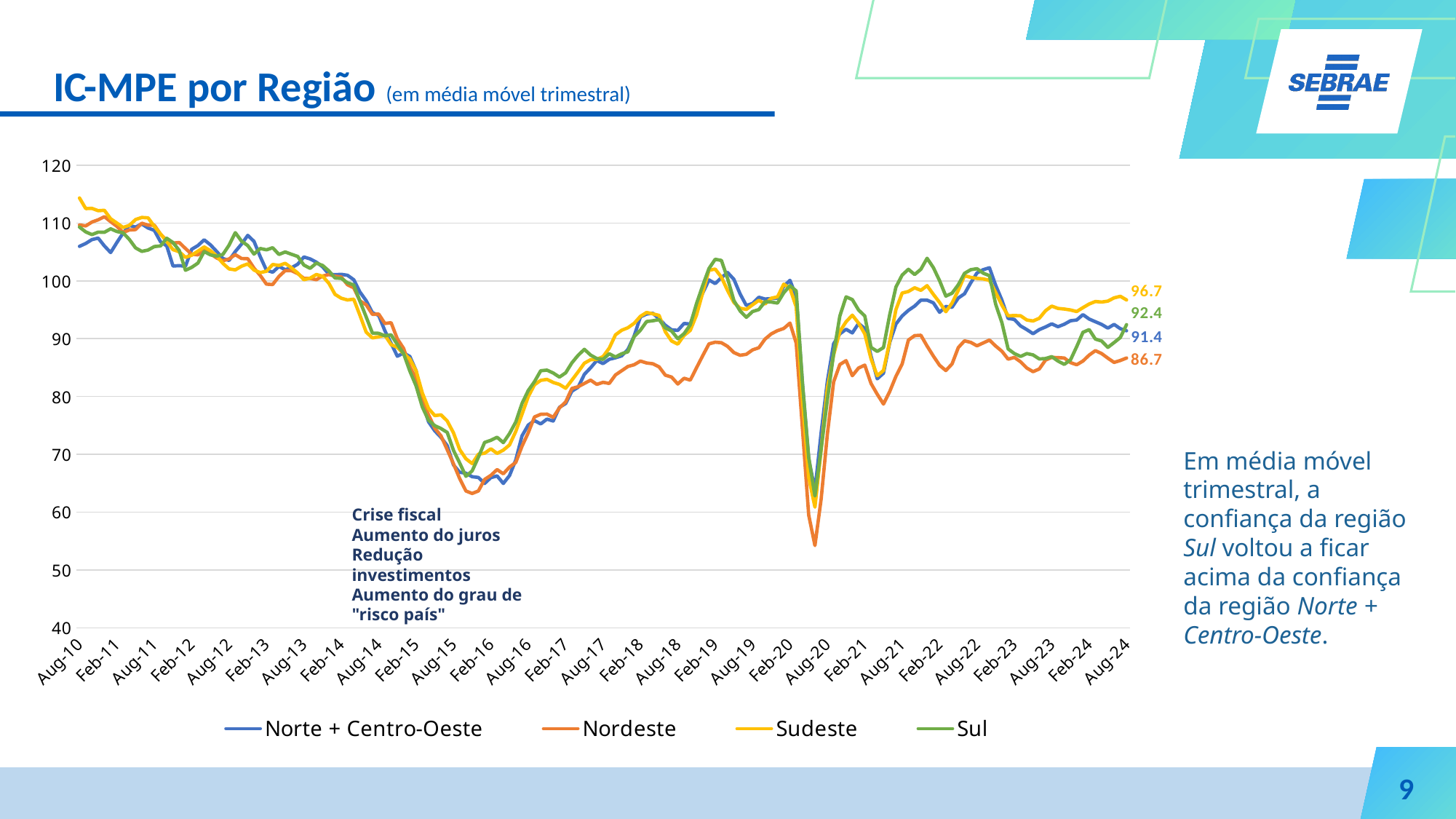
What is the value for Nordeste at Aug-24, as labelled at the end of the line? 86.7 What kind of chart is shown on the slide? line chart What is the value for Sudeste at Aug-24, as labelled at the end of the line? 96.7 What is the value for Norte + Centro-Oeste at Aug-24, as labelled at the end of the line? 91.4 What is the difference between the Sudeste and Nordeste values at Aug-24? 10.0 What is the value for Sul at Aug-24, as labelled at the end of the line? 92.4 Is the lowest value of the Nordeste line around Aug-20 greater or less than 60? less At Aug-24, which is larger: the value for Sul or the value for Norte + Centro-Oeste? Sul Which region has the highest value at Aug-24? Sudeste How many series does the legend list? 4 What is the title of the chart on the slide? IC-MPE por Região Which region has the lowest value at Aug-24? Nordeste